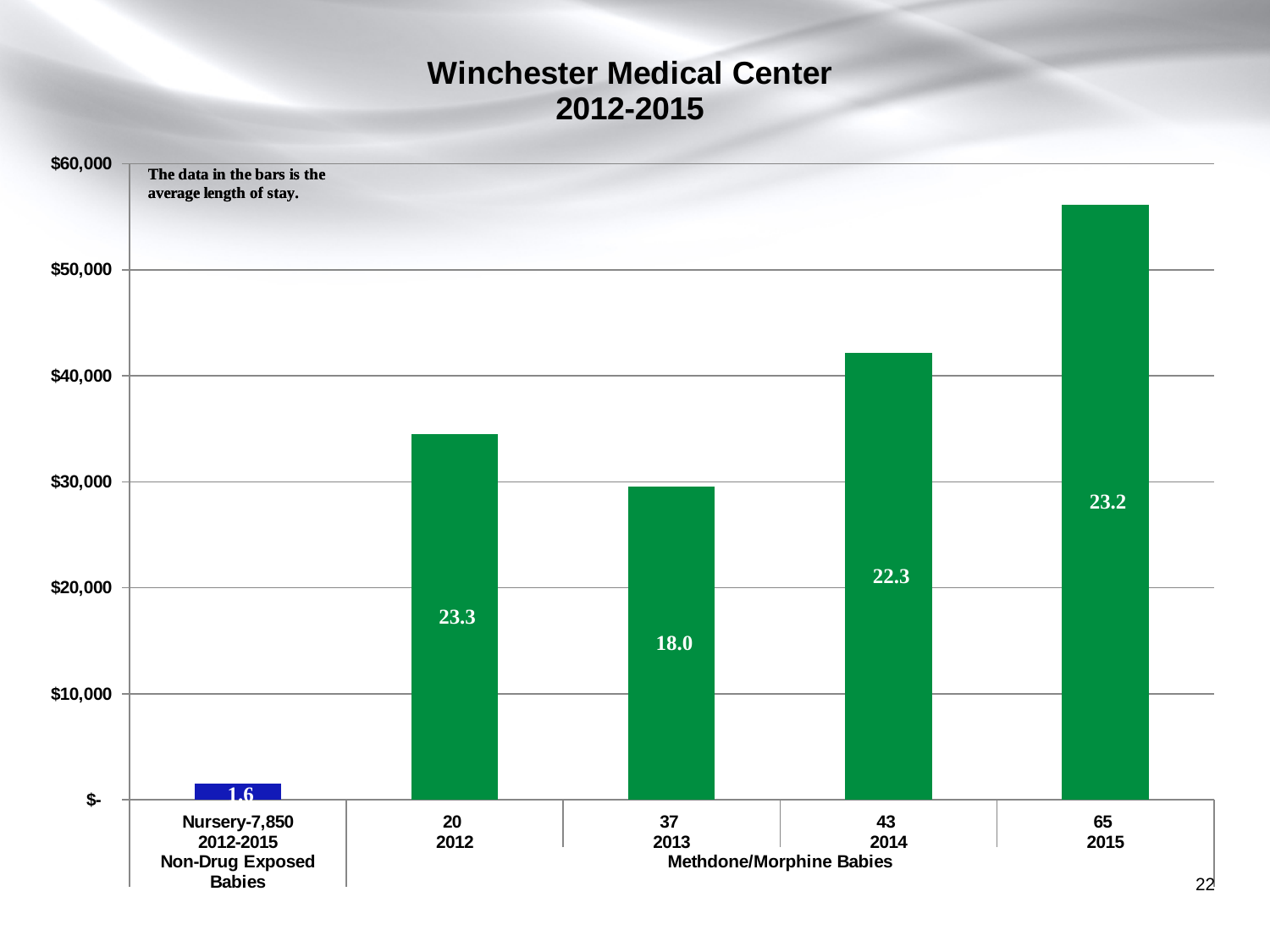
How many bars are plotted in the chart? 5 What is the title of the chart? Winchester Medical Center 2012-2015 Is the bar for 2015 (65 Methadone/Morphine Babies) greater or less than $50,000? greater According to the note on the chart, what does the data printed in the bars represent? The average length of stay What is the average length of stay printed in the bar for 2014 (43 Methadone/Morphine Babies)? 22.3 What is the average length of stay printed in the bar for 2015 (65 Methadone/Morphine Babies)? 23.2 Which category has the shortest bar in the chart? Nursery-7,850 2012-2015 Non-Drug Exposed Babies What is the average length of stay printed in the Nursery Non-Drug Exposed Babies bar? 1.6 What is the average length of stay printed in the bar for 2013 (37 Methadone/Morphine Babies)? 18.0 Which bar is taller, the one for 2012 (20 babies) or the one for 2013 (37 babies)? 2012 (20 babies) Which category has the tallest bar in the chart? 65 2015 (Methadone/Morphine Babies) What type of chart is shown on the slide? bar chart